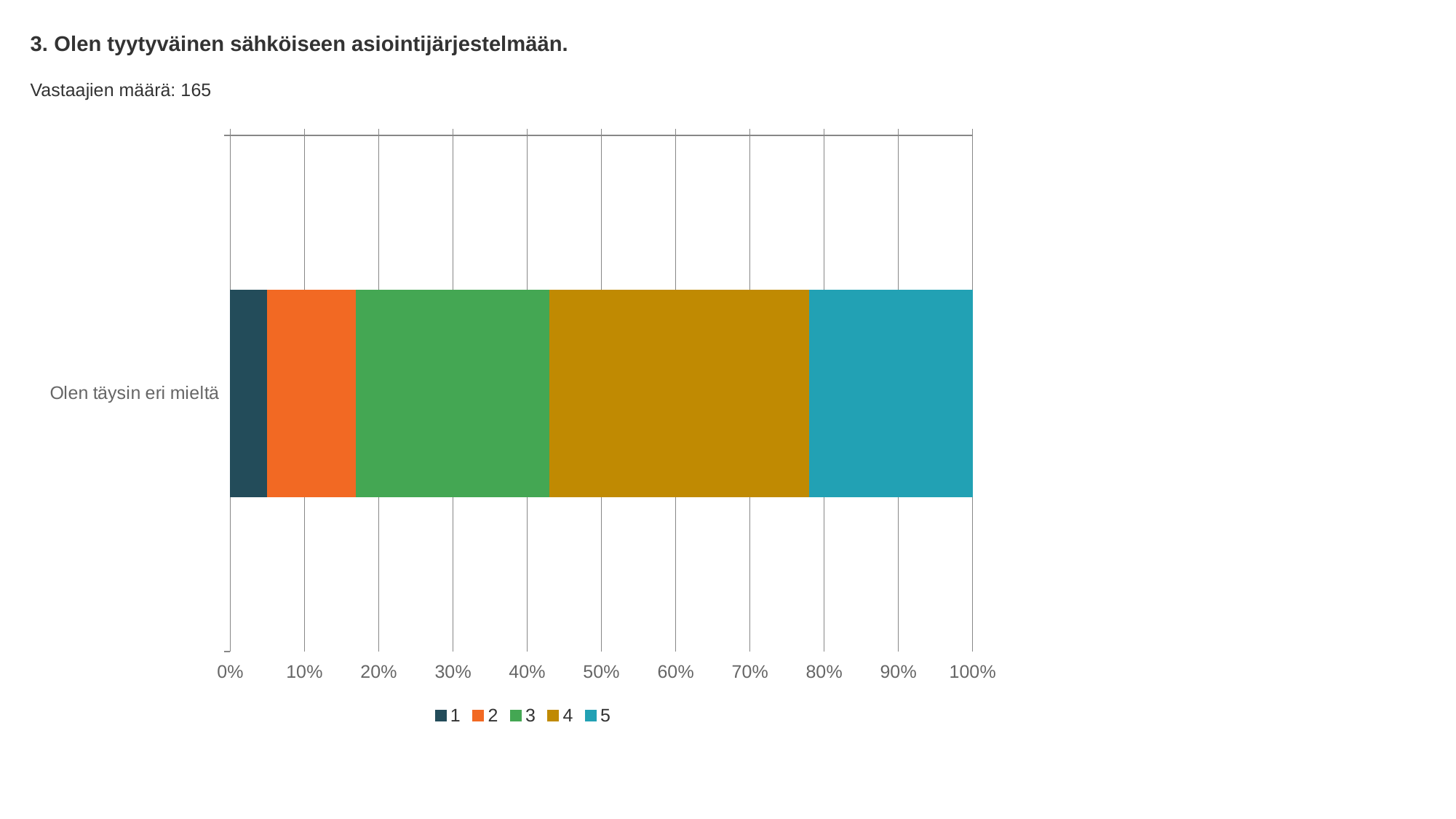
What is the title of the chart? 3. Olen tyytyväinen sähköiseen asiointijärjestelmään. What kind of chart is shown on the slide? Stacked bar chart How many respondents (Vastaajien määrä) are reported on the slide? 165 Which series has the smallest segment in the bar? 1 Which segment is larger, series 4 or series 3? 4 Is the share for series 1 greater or less than 10%? less Which series has the largest segment in the bar? 4 How many categories are plotted on the y axis? 1 What is the total of the stacked bar for 'Olen täysin eri mieltä'? 100% Is the share for series 4 greater or less than 30%? greater How many series does the legend list? 5 Which segment is larger, series 2 or series 1? 2